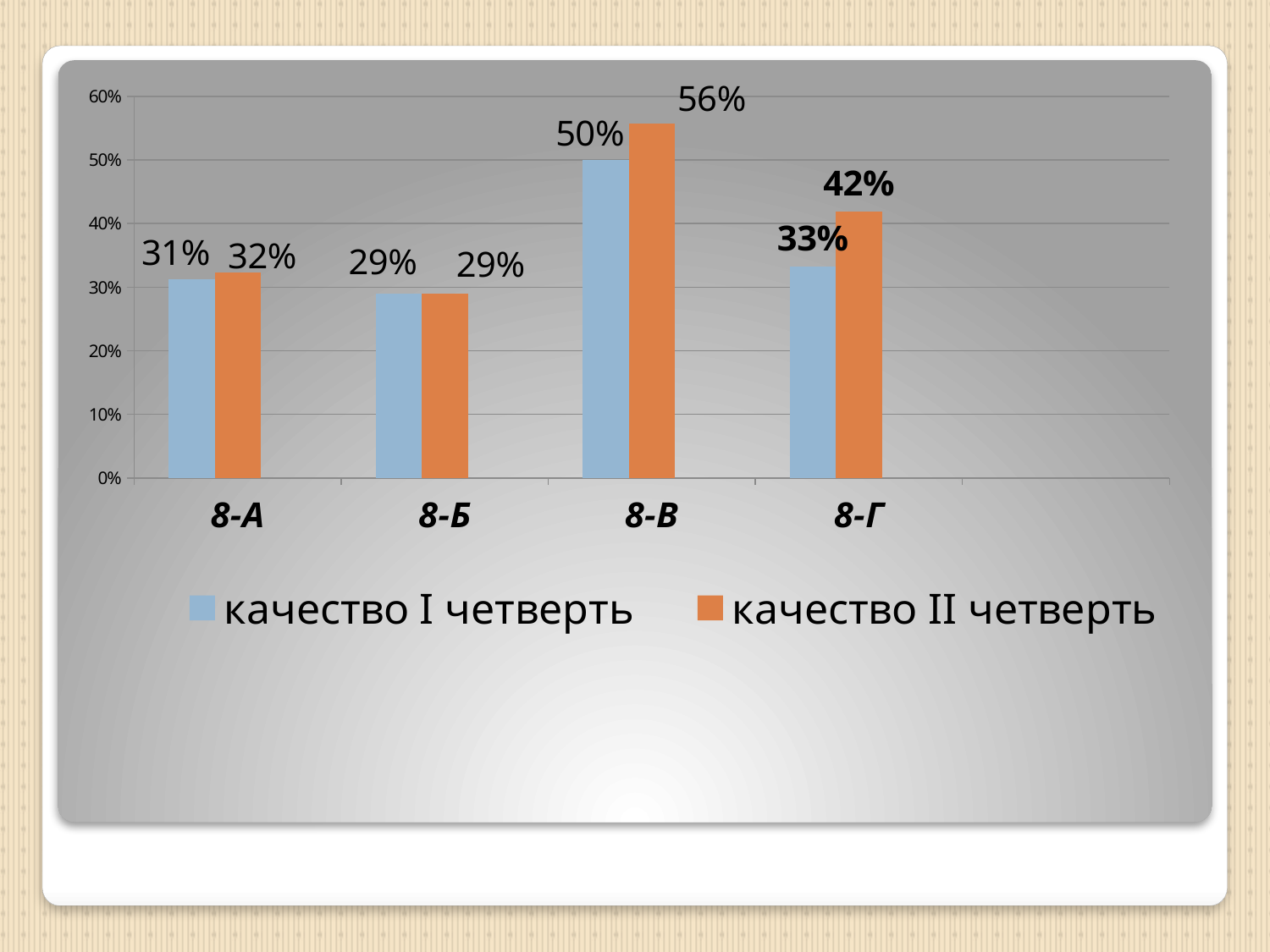
How many series does the legend list? 2 Which is larger for 8-Г: качество I четверть or качество II четверть? качество II четверть Which is larger for 8-Б: качество I четверть or качество II четверть? They are equal (29%) How many categories are shown on the x axis? 4 What is the value for 8-А in the series качество II четверть? 32% What is the value for 8-Г in the series качество I четверть? 33% What kind of chart is shown on the slide? Bar chart What is the difference between the качество II четверть and качество I четверть values for 8-Г? 9% Which category has the highest value in the series качество I четверть? 8-В What is the value for 8-В in the series качество II четверть? 56% What is the difference between the качество II четверть and качество I четверть values for 8-В? 6% Which category has the lowest value in the series качество II четверть? 8-Б